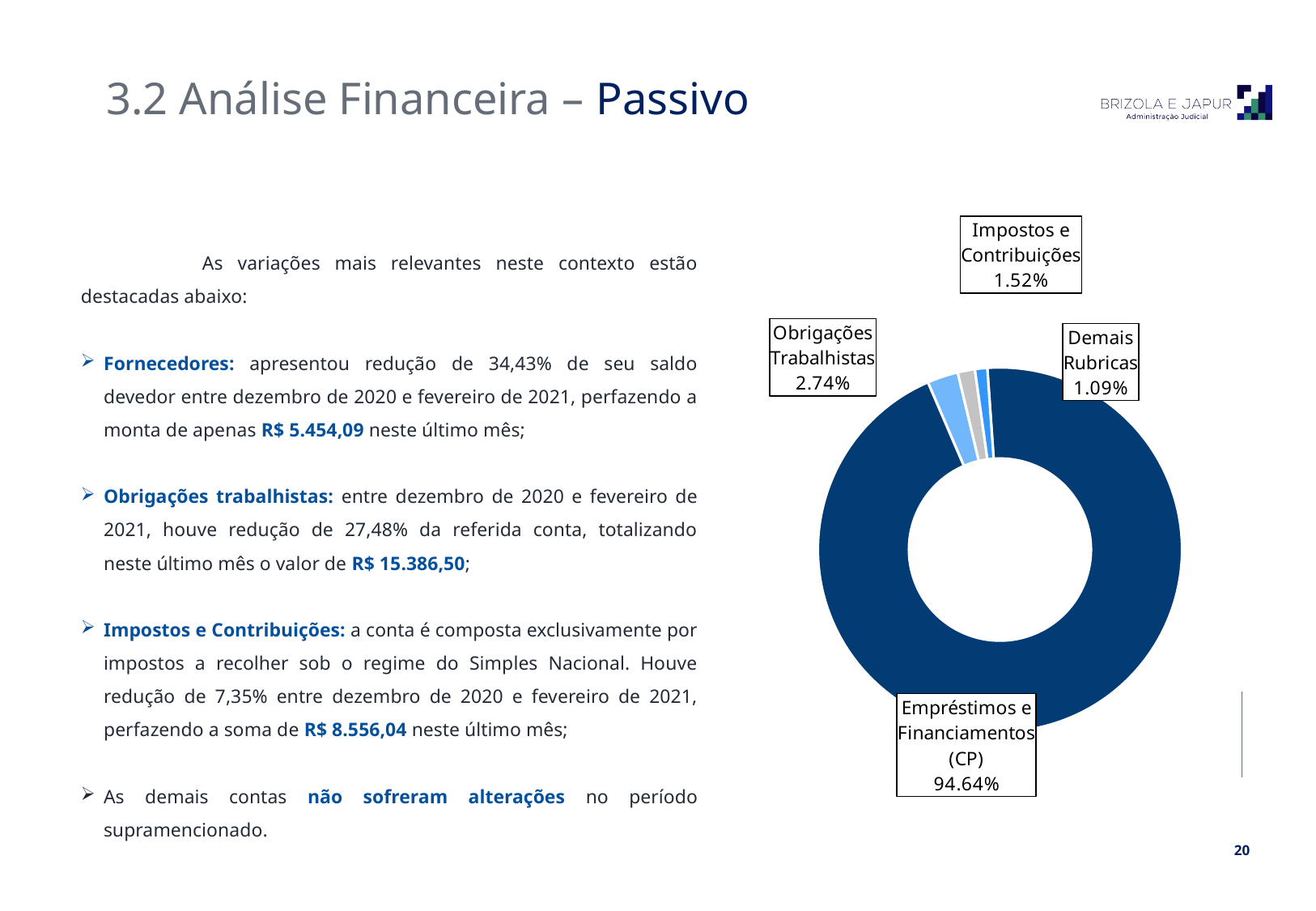
How many categories are shown in the chart? 4 What is the difference between the shares of Obrigações Trabalhistas and Impostos e Contribuições? 1.22% Which category has the largest share in the chart? Empréstimos e Financiamentos (CP) What is the title of the slide containing the chart? 3.2 Análise Financeira – Passivo What share of the chart does Empréstimos e Financiamentos (CP) represent? 94.64% What is the difference between the shares of Impostos e Contribuições and Demais Rubricas? 0.43% What kind of chart is shown on the slide? Doughnut (pie) chart Which is larger: the share of Obrigações Trabalhistas or the share of Impostos e Contribuições? Obrigações Trabalhistas What share of the chart does Impostos e Contribuições represent? 1.52% What share of the chart does Obrigações Trabalhistas represent? 2.74% What share of the chart does Demais Rubricas represent? 1.09% Which category has the smallest share in the chart? Demais Rubricas